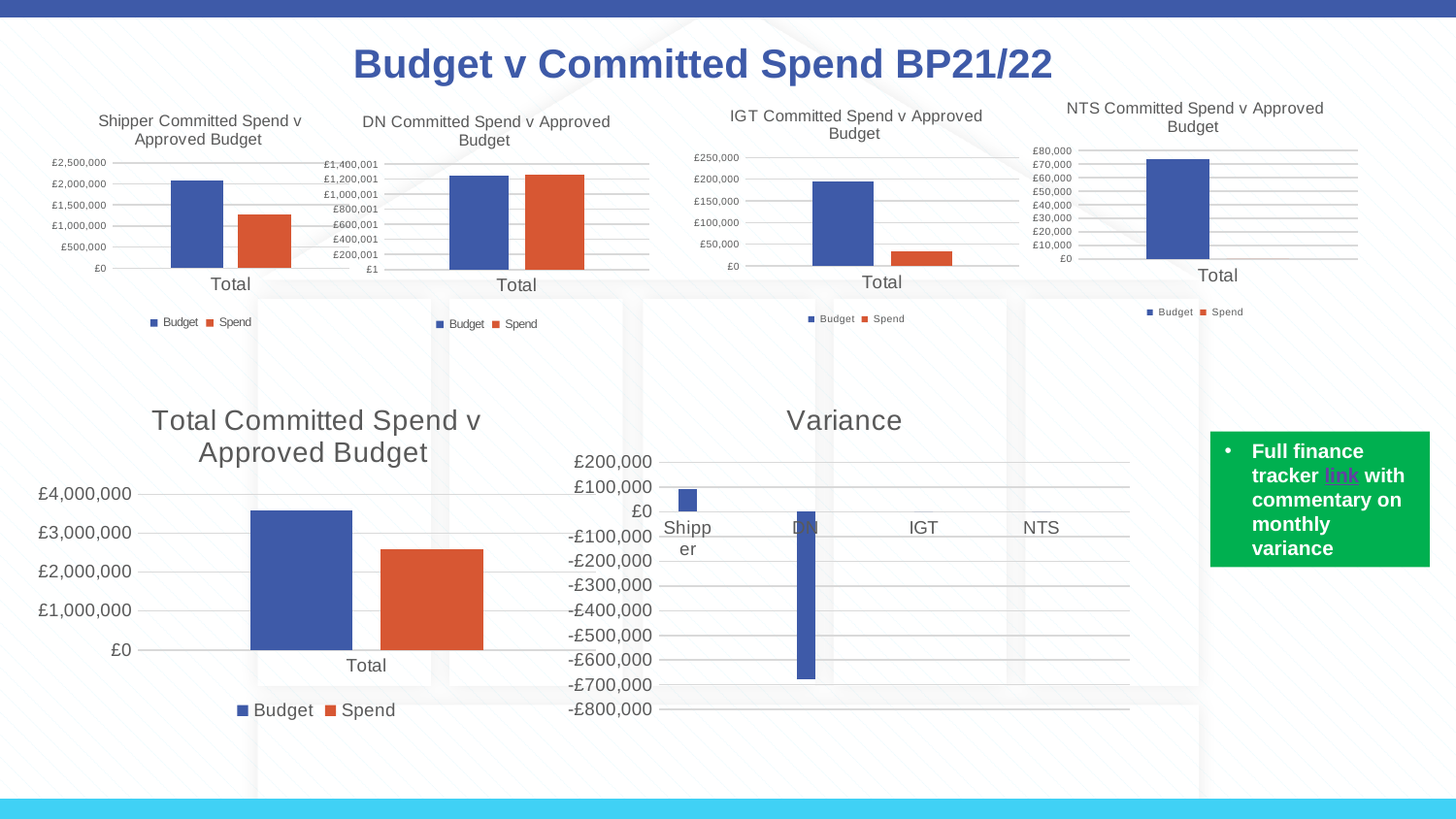
In the NTS Committed Spend v Approved Budget chart, is the Budget value greater or less than £60,000? greater In the Variance chart, how many categories are shown on the x axis? 4 In the Total Committed Spend v Approved Budget chart, is the Spend value greater or less than £3,000,000? less In the IGT Committed Spend v Approved Budget chart, is the Spend value greater or less than £50,000? less What kind of chart is the Variance chart? Bar chart How many series does the legend of the Total Committed Spend v Approved Budget chart list? 2 In the Shipper Committed Spend v Approved Budget chart, which is larger, Budget or Spend? Budget